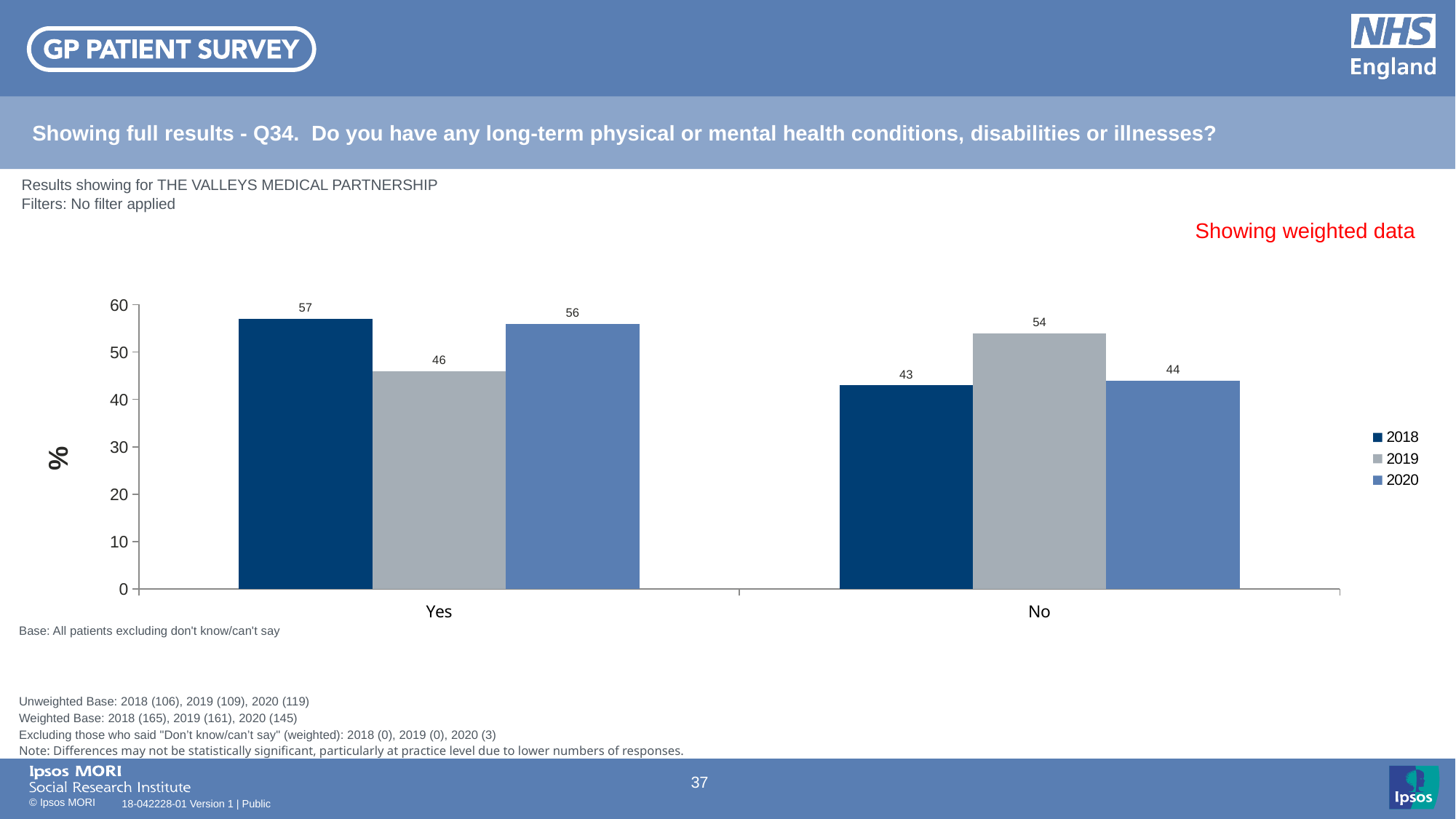
How many categories are shown on the x axis? 2 Which is larger: the 2019 value for 'No' or the 2020 value for 'No'? 2019 Which year has the highest value for 'No'? 2019 What is the difference between the 2018 and 2019 values for 'Yes'? 11 What is the value for 'No' in 2018? 43 What is the label on the y axis? % How many series does the legend list? 3 What kind of chart is shown on the slide? Bar chart What is the value for 'No' in 2019? 54 What is the value for 'Yes' in 2018? 57 What is the value for 'Yes' in 2020? 56 Which year has the lowest value for 'Yes'? 2019